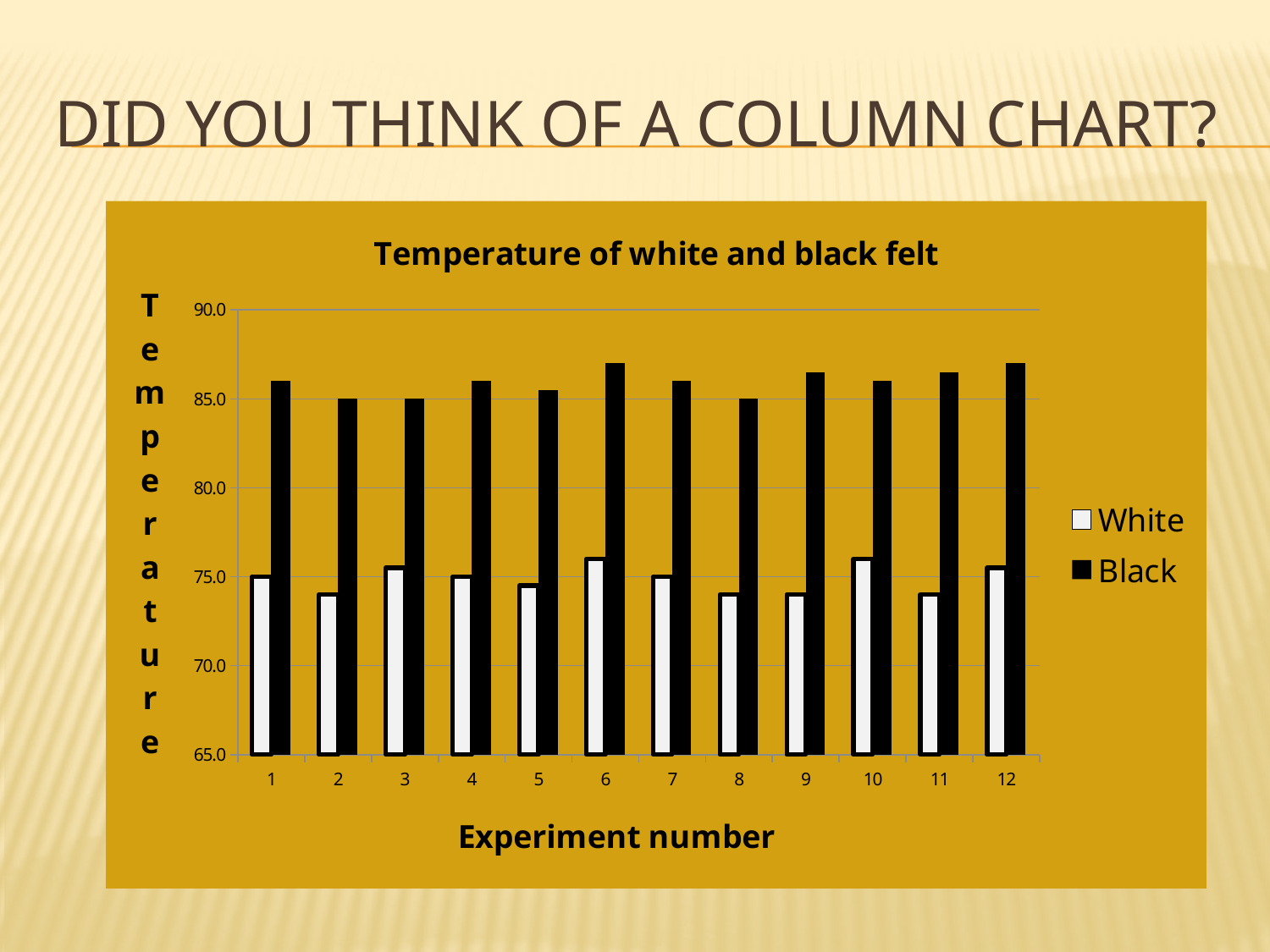
Is the White value for experiment 2 greater or less than 80.0? less What is the title of the chart? Temperature of white and black felt For experiment 12, which series has the larger value, White or Black? Black Is the Black value for experiment 1 greater or less than 80.0? greater Is the Black value for experiment 6 greater or less than 85.0? greater For experiment 1, which series has the larger value, White or Black? Black Which two series are listed in the legend? White and Black How many series does the legend list? 2 How many experiment numbers are shown on the x axis? 12 What kind of chart is shown on the slide? Bar chart